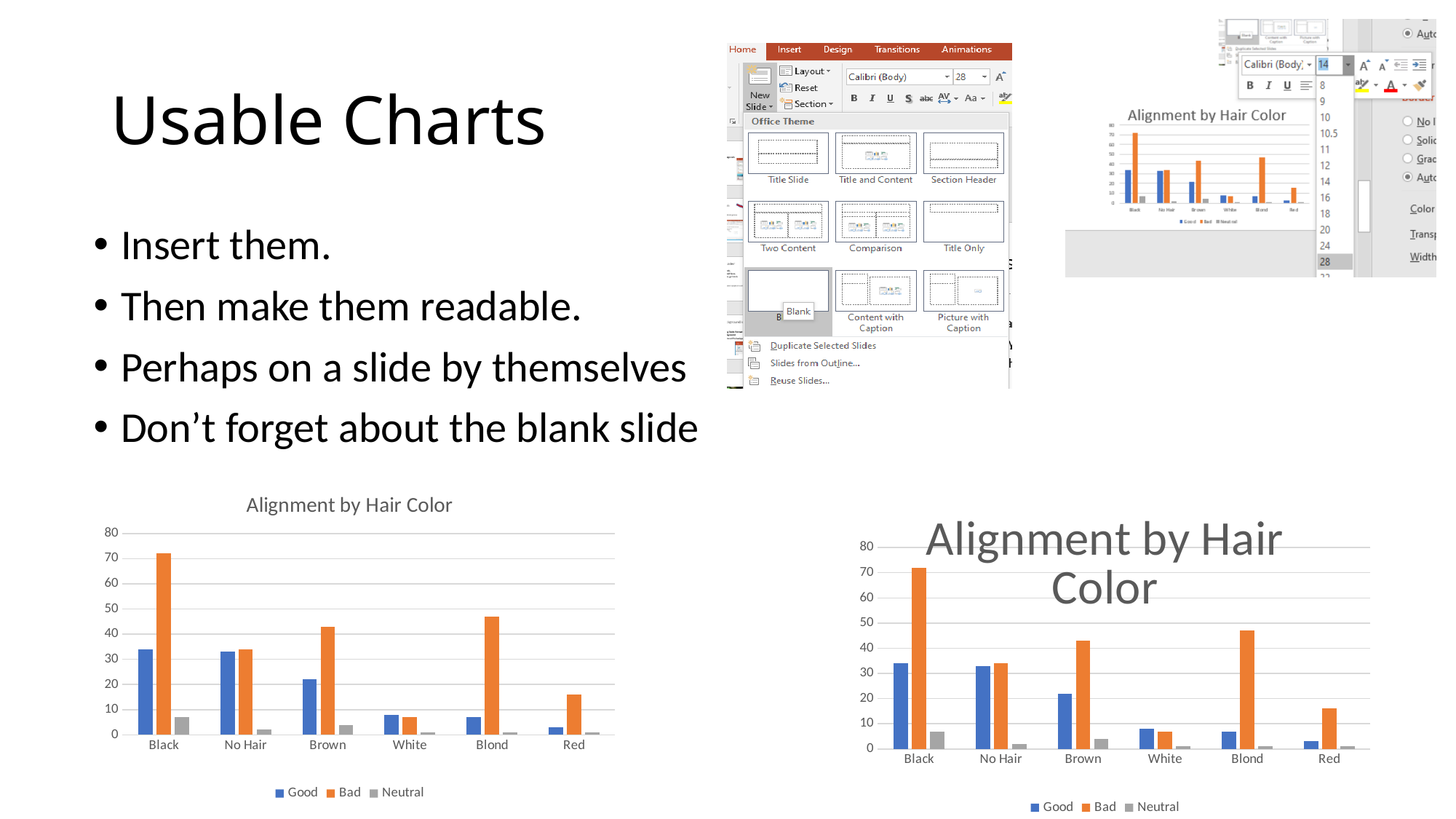
In the bottom-right chart, which hair color has the lowest Good value? Red In the bottom-left chart, is the Bad value for Black greater or less than 70? greater In the bottom-right chart, is the Bad value for Blond greater or less than 40? greater In the bottom-left chart, is the Good value for Brown greater or less than 30? less What is the title of the bottom-right chart? Alignment by Hair Color In the bottom-right chart, which is larger for Brown: the Good value or the Bad value? Bad What kind of chart is the bottom-left chart? bar chart In the bottom-right chart, which series is shown in orange? Bad In the bottom-left chart, which hair color has the highest Bad value? Black In the bottom-left chart, how many hair color categories are shown on the x axis? 6 In the bottom-left chart, how many series does the legend list? 3